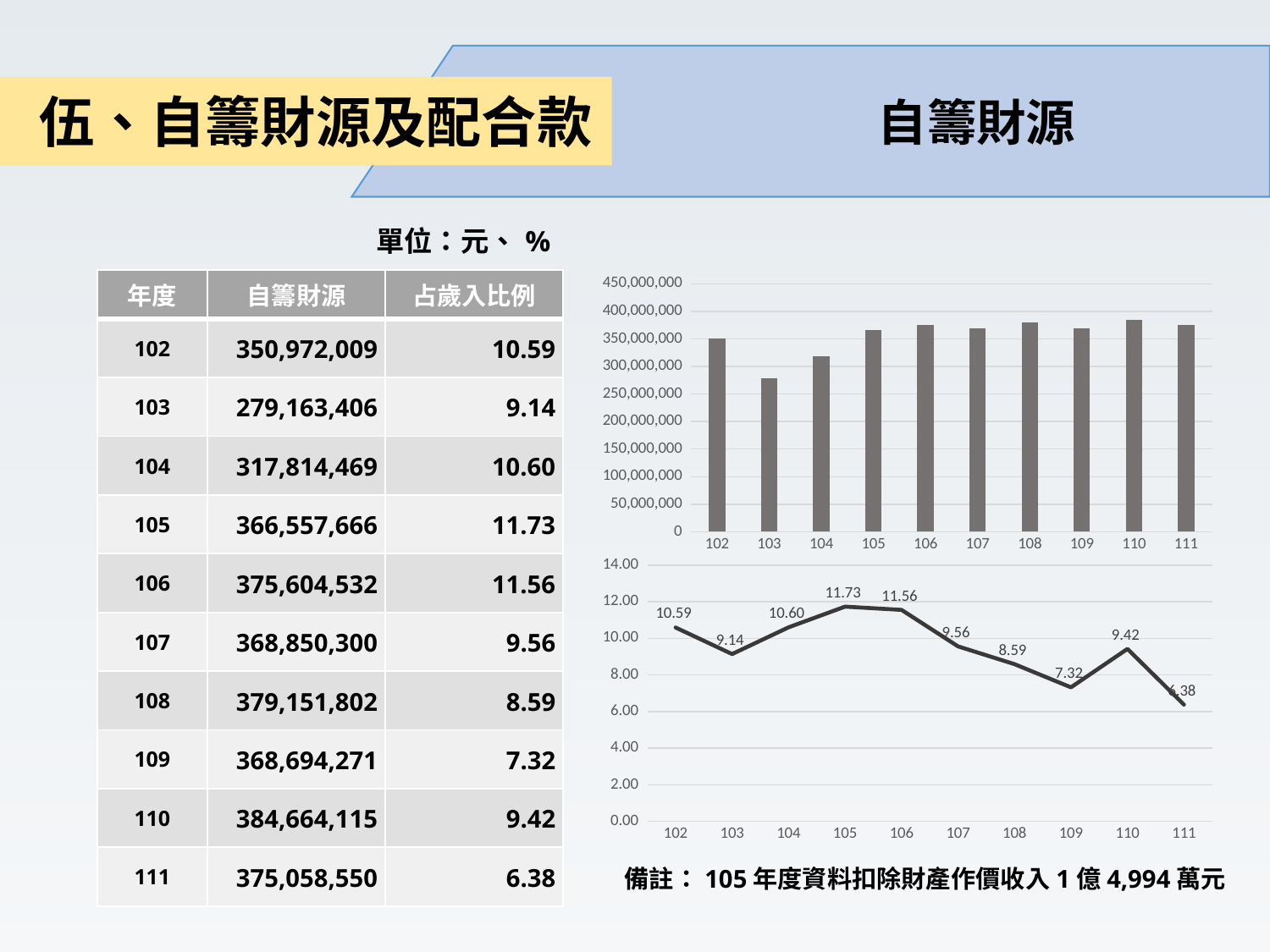
What kind of chart is the upper chart on the right of the slide? bar chart In the upper bar chart, is the value for 103 greater or less than 300,000,000? less In the lower line chart, what is the value for 111? 6.38 In the lower line chart, what is the difference between the values for 105 and 111? 5.35 In the upper bar chart, is the value for 102 greater or less than 300,000,000? greater In the upper bar chart, which year has the lowest bar? 103 In the upper bar chart, which bar is taller, 102 or 103? 102 In the lower line chart, what is the value for 105? 11.73 In the upper bar chart, how many years are plotted along the x axis? 10 What kind of chart is the lower chart on the right of the slide? line chart In the lower line chart, do the values rise or fall from 106 to 109? fall In the lower line chart, which year has the highest value? 105